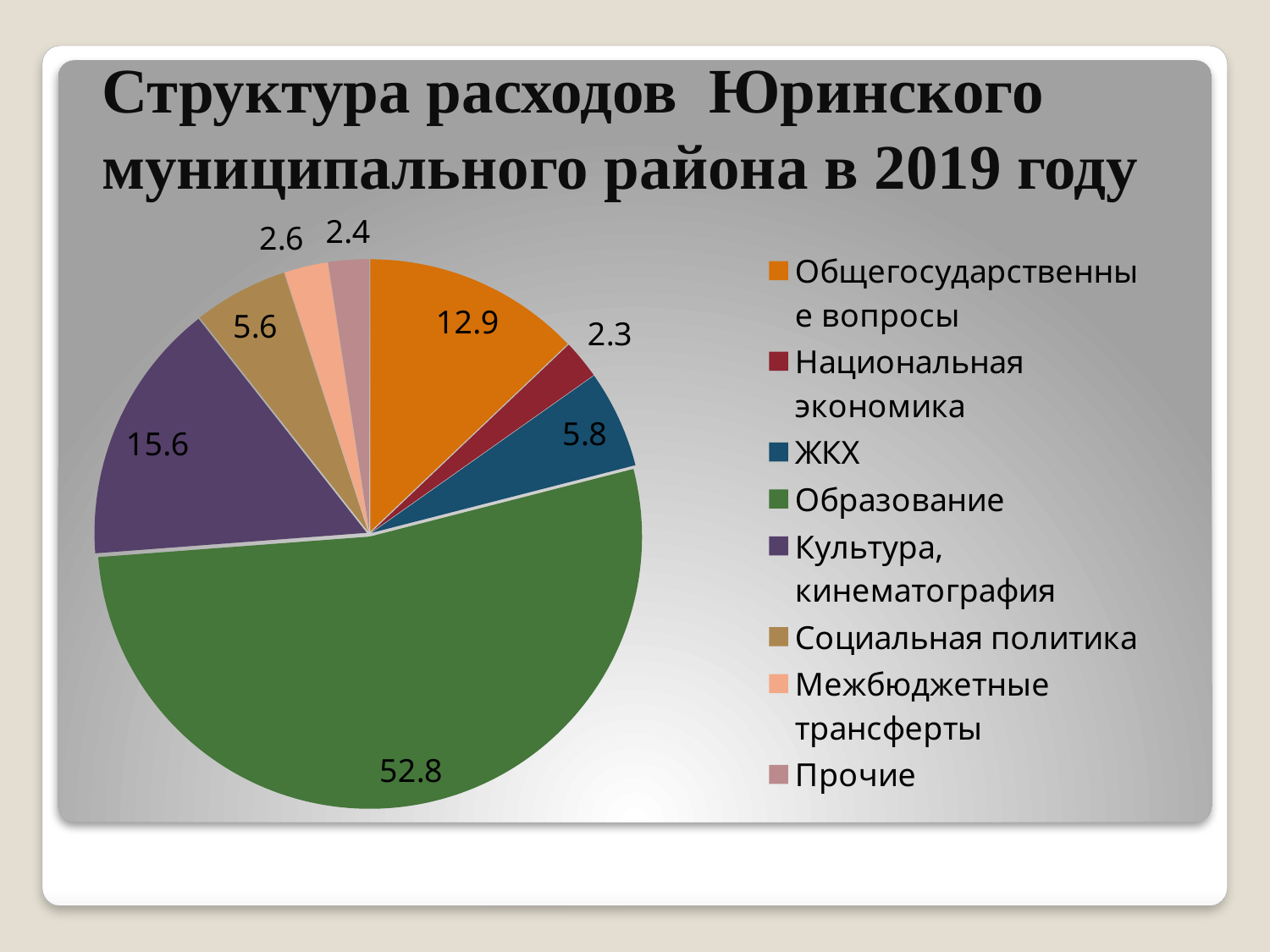
What is the difference between the values for Межбюджетные трансферты and Прочие? 0.2 What is the value for Образование? 52.8 What is the difference between the values for Образование and Культура, кинематография? 37.2 How many categories does the pie chart show? 8 Which is larger, the value for Социальная политика or the value for ЖКХ? ЖКХ What colour is the slice for Образование? Green Which category has the largest slice of the pie? Образование What is the value for Общегосударственные вопросы? 12.9 What kind of chart is shown on the slide? Pie chart What is the value for Культура, кинематография? 15.6 Which category has the smallest slice of the pie? Национальная экономика What is the value for ЖКХ? 5.8